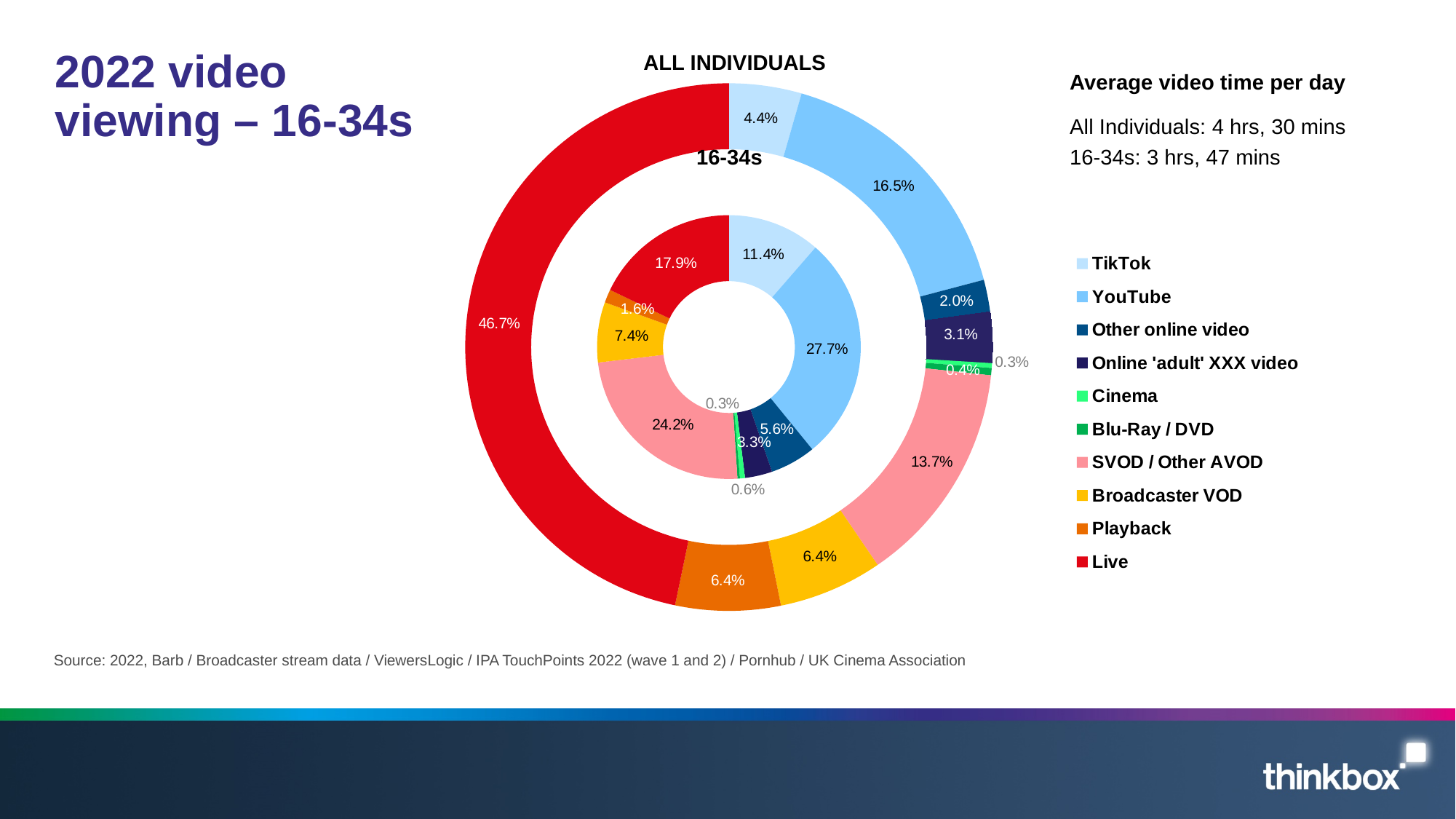
Which is larger for 16-34s (inner ring): the SVOD / Other AVOD share or the Live share? SVOD / Other AVOD How many entries does the legend list? 10 Which category has the largest share in the inner ring (16-34s)? YouTube What kind of chart is shown on the slide? Doughnut chart In the outer ring (All Individuals), what share of video viewing is SVOD / Other AVOD? 13.7% What is the difference between the Live share for All Individuals (outer ring) and for 16-34s (inner ring)? 28.8 percentage points In the outer ring (All Individuals), what share of video viewing is Live? 46.7% In the inner ring (16-34s), what share of video viewing is YouTube? 27.7% Which category has the largest share in the outer ring (All Individuals)? Live According to the text on the slide, what is the average video time per day for 16-34s? 3 hrs, 47 mins In the inner ring (16-34s), what share of video viewing is TikTok? 11.4% In the inner ring (16-34s), what share of video viewing is Playback? 1.6%